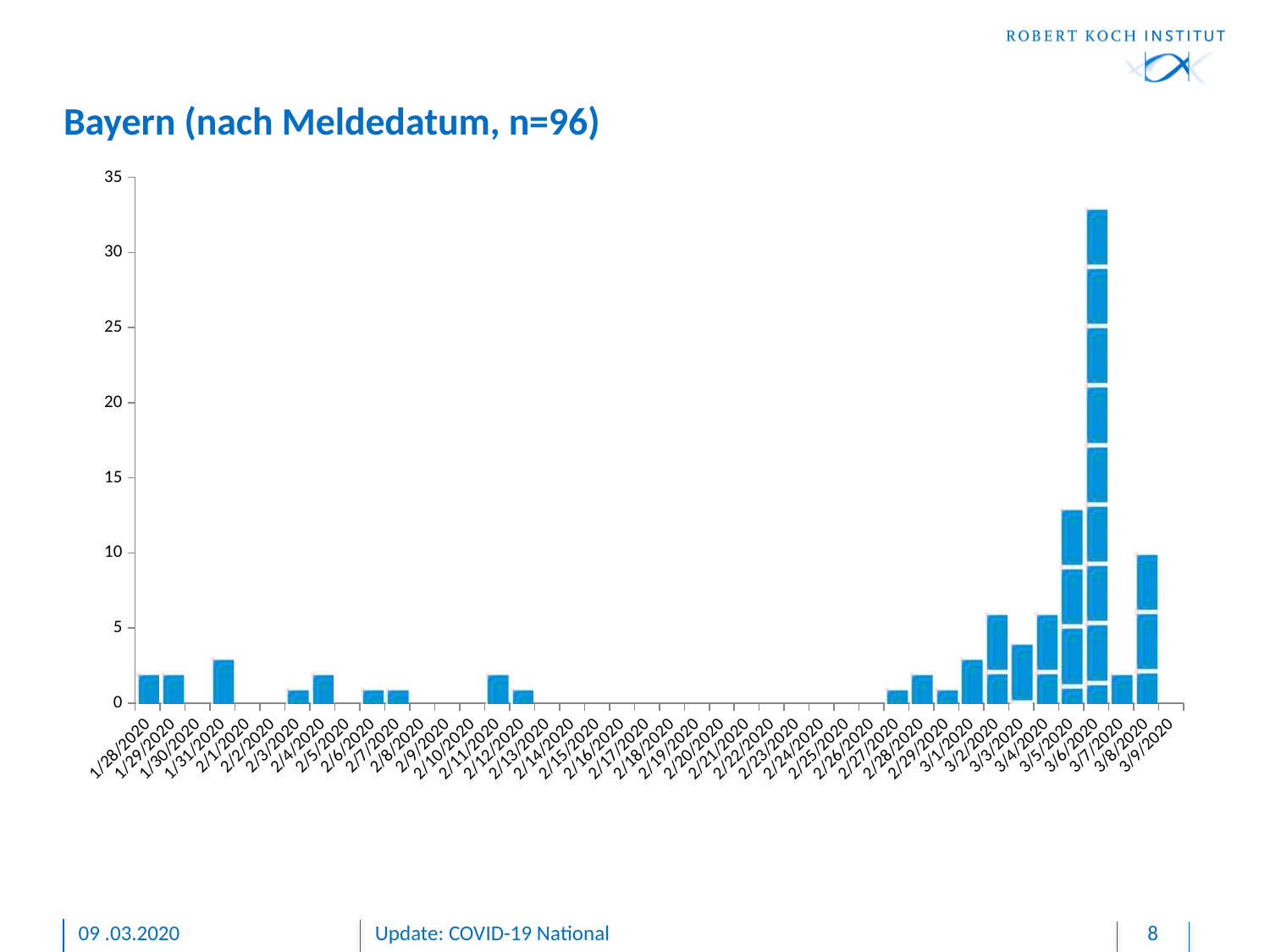
Is the value for 3/6/2020 greater or less than 30? greater Is the value for 3/8/2020 greater or less than 15? less Which date has the larger value, 3/4/2020 or 3/5/2020? 3/5/2020 Which date has the larger value, 3/5/2020 or 3/6/2020? 3/6/2020 Which date has the highest bar in the chart? 3/6/2020 Do the values generally rise or fall toward the end of the date range on the x axis? rise What kind of chart is shown on the slide? bar chart Is the value for 3/2/2020 greater or less than 5? greater How many dates are shown on the x axis of the chart? 42 What is the title of the chart? Bayern (nach Meldedatum, n=96)